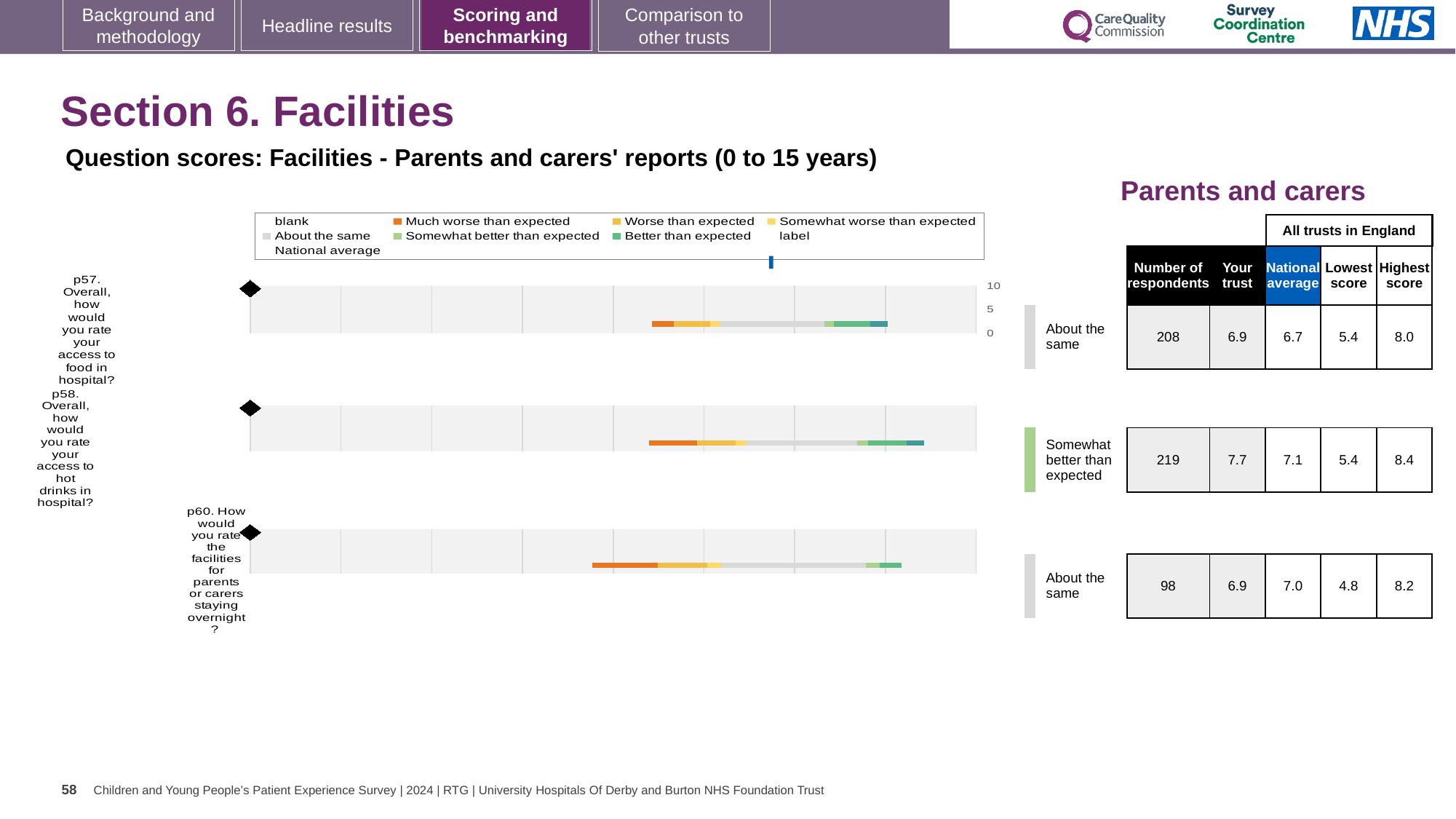
How many respondents answered p57 (access to food in hospital)? 208 What is the highest score across all trusts in England for p58? 8.4 How many questions (bars) are plotted in the Facilities chart? 3 What kind of chart is used to show the question scores for Facilities? Bar chart What is the 'Your trust' score for p58 (access to hot drinks in hospital)? 7.7 In the legend of the Facilities chart, what colour represents 'Much worse than expected'? Orange How many entries does the legend of the Facilities chart list? 9 What benchmark category is shown for p60 (facilities for parents or carers staying overnight)? About the same Which question has the highest 'Your trust' score? p58 What is the difference between the 'Your trust' score and the national average for p58? 0.6 What is the national average score for p60 (facilities for parents or carers staying overnight)? 7.0 For p57, which is larger: the 'Your trust' score or the national average? Your trust